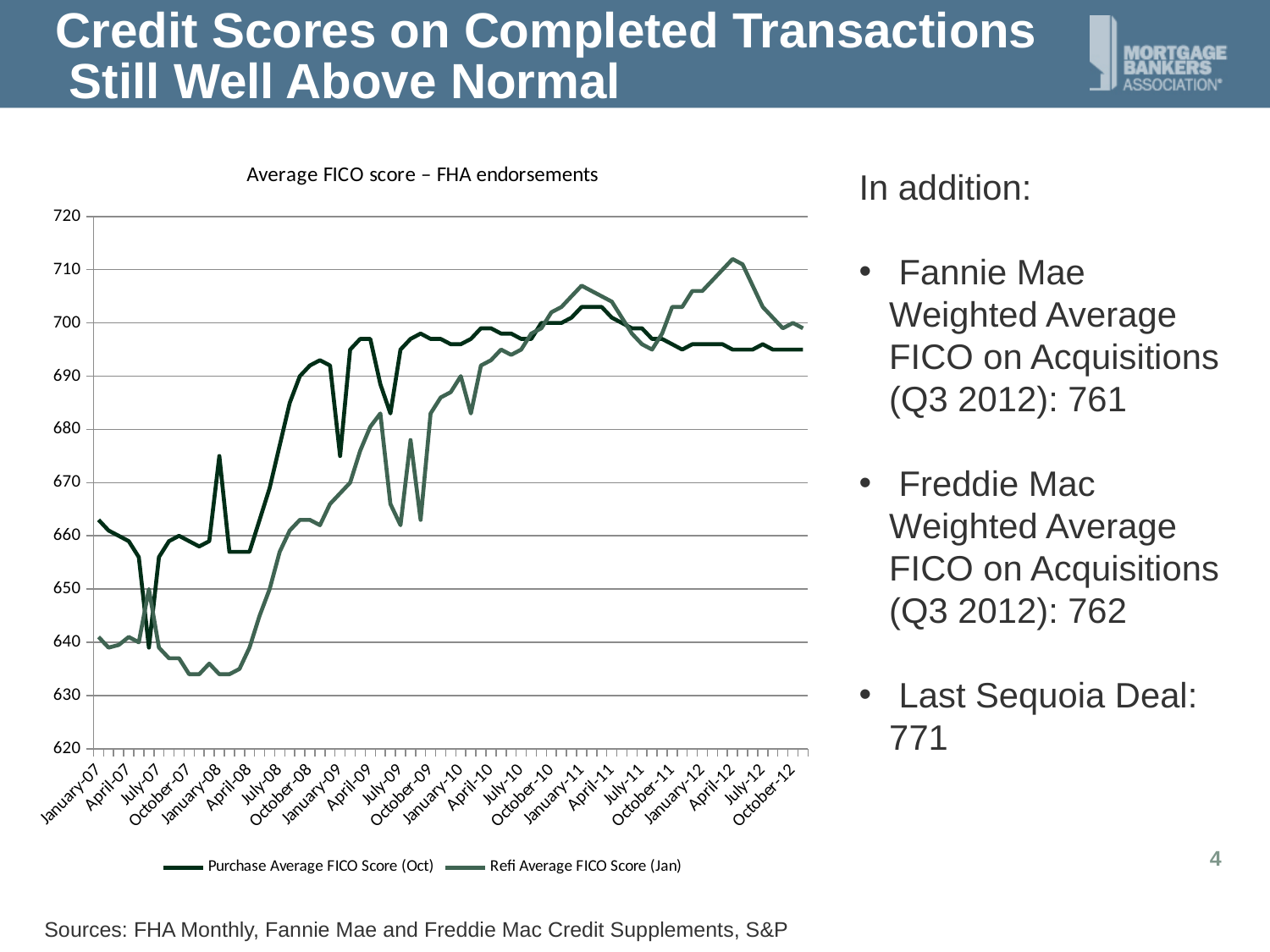
What kind of chart is shown on the slide? line chart Is the Purchase Average FICO Score at October-12 greater or less than 700? less At January-07, which series has the higher value, Purchase Average FICO Score or Refi Average FICO Score? Purchase Average FICO Score Is the Purchase Average FICO Score at January-07 greater or less than 660? greater At April-12, which series has the higher value, Purchase Average FICO Score or Refi Average FICO Score? Refi Average FICO Score Which series reaches the highest value anywhere on the chart? Refi Average FICO Score (Jan) Is the Refi Average FICO Score at October-07 greater or less than 640? less Overall, does the Purchase Average FICO Score rise or fall from January-07 to October-12? rise How many series does the chart's legend list? 2 What are the two series named in the chart legend? Purchase Average FICO Score (Oct) and Refi Average FICO Score (Jan) What is the title of the chart? Average FICO score – FHA endorsements